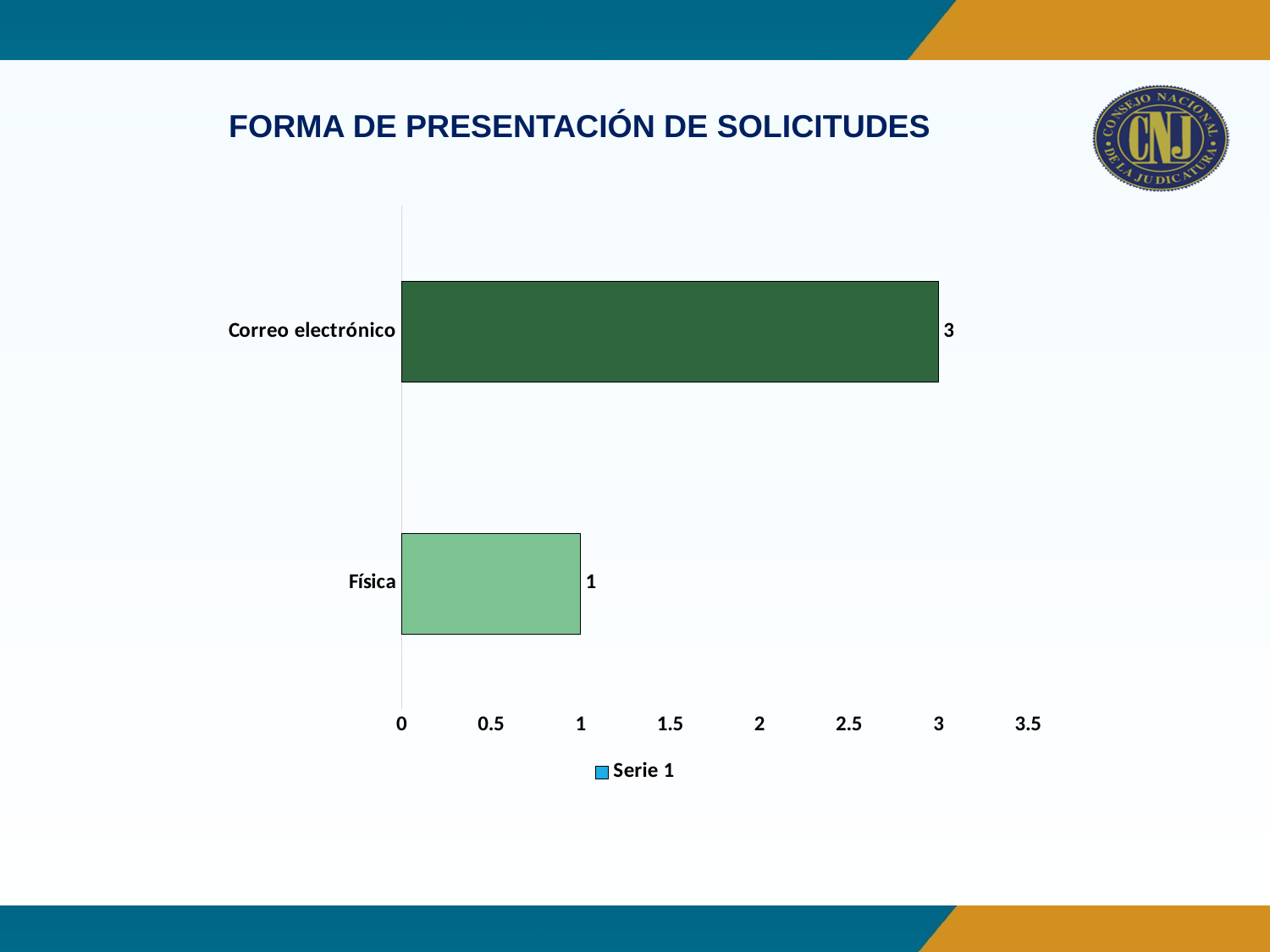
Is the value for Correo electrónico greater or less than 2? greater How many series does the legend list? 1 What is the value for Correo electrónico? 3 Is the value for Física greater or less than 2? less What is the value for Física? 1 Which is larger, the value for Correo electrónico or the value for Física? Correo electrónico Which category has the highest value? Correo electrónico How many categories are shown in the chart? 2 What is the name of the series listed in the legend? Serie 1 What is the difference between the values for Correo electrónico and Física? 2 Which category has the lowest value? Física What kind of chart is shown on the slide? Bar chart